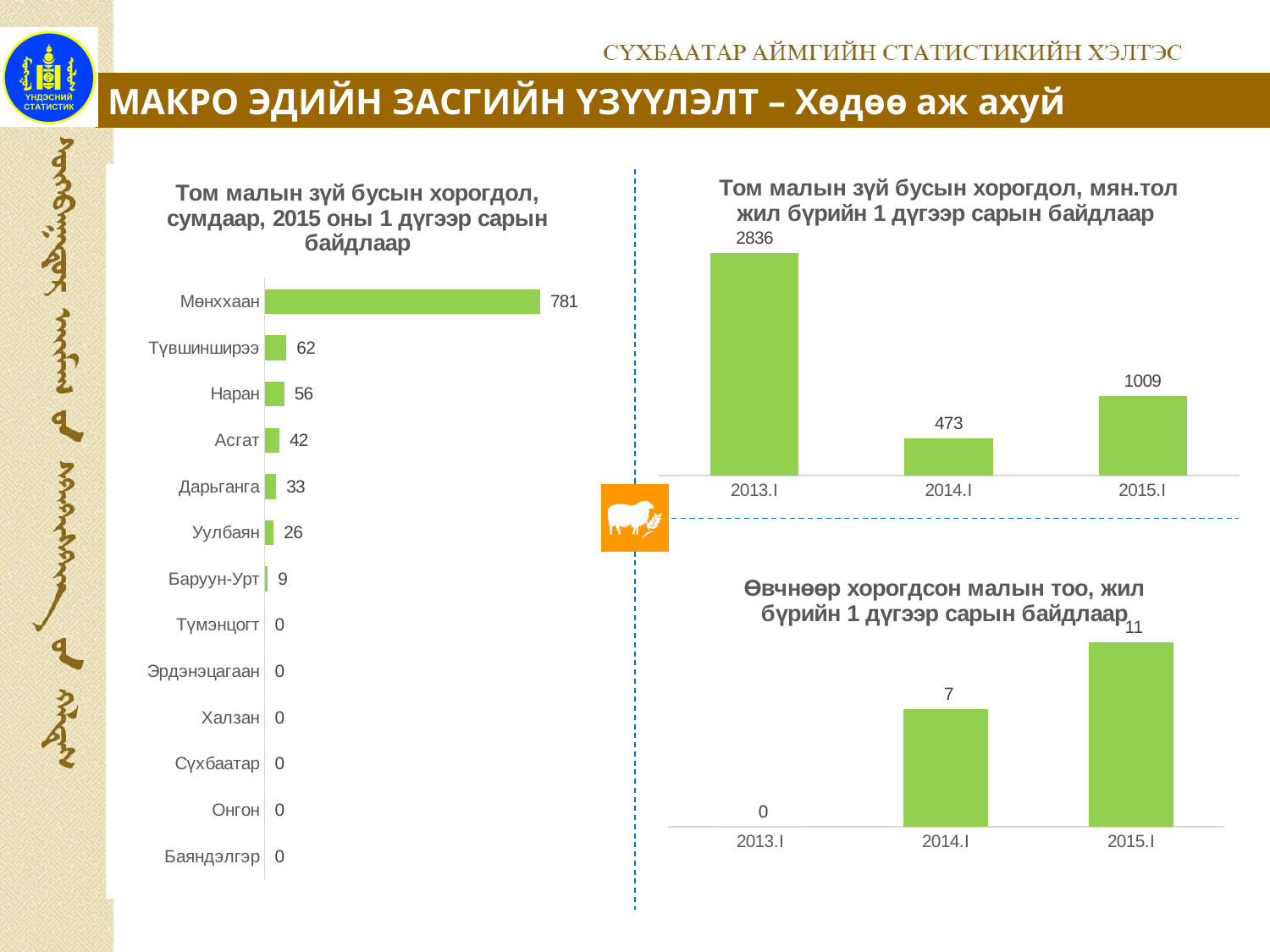
In the left chart (Том малын зүй бусын хорогдол, сумдаар), how many soums are listed? 13 In the left chart (Том малын зүй бусын хорогдол, сумдаар), what is the difference between Түвшинширээ and Наран? 6 In the left chart (Том малын зүй бусын хорогдол, сумдаар), which soum has the highest value? Мөнххаан In the left chart (Том малын зүй бусын хорогдол, сумдаар), what is the value for Мөнххаан? 781 In the left chart (Том малын зүй бусын хорогдол, сумдаар), what is the value for Дарьганга? 33 In the bottom right chart (Өвчнөөр хорогдсон малын тоо), what is the value for 2015.I? 11 In the top right chart (Том малын зүй бусын хорогдол, мян.тол), what is the value for 2013.I? 2836 What type of chart is the left chart (Том малын зүй бусын хорогдол, сумдаар)? bar chart In the bottom right chart (Өвчнөөр хорогдсон малын тоо), do the values rise or fall from 2013.I to 2015.I? rise In the left chart (Том малын зүй бусын хорогдол, сумдаар), which is larger, Асгат or Уулбаян? Асгат In the top right chart (Том малын зүй бусын хорогдол, мян.тол), which year has the lowest value? 2014.I In the top right chart (Том малын зүй бусын хорогдол, мян.тол), what is the difference between 2015.I and 2014.I? 536